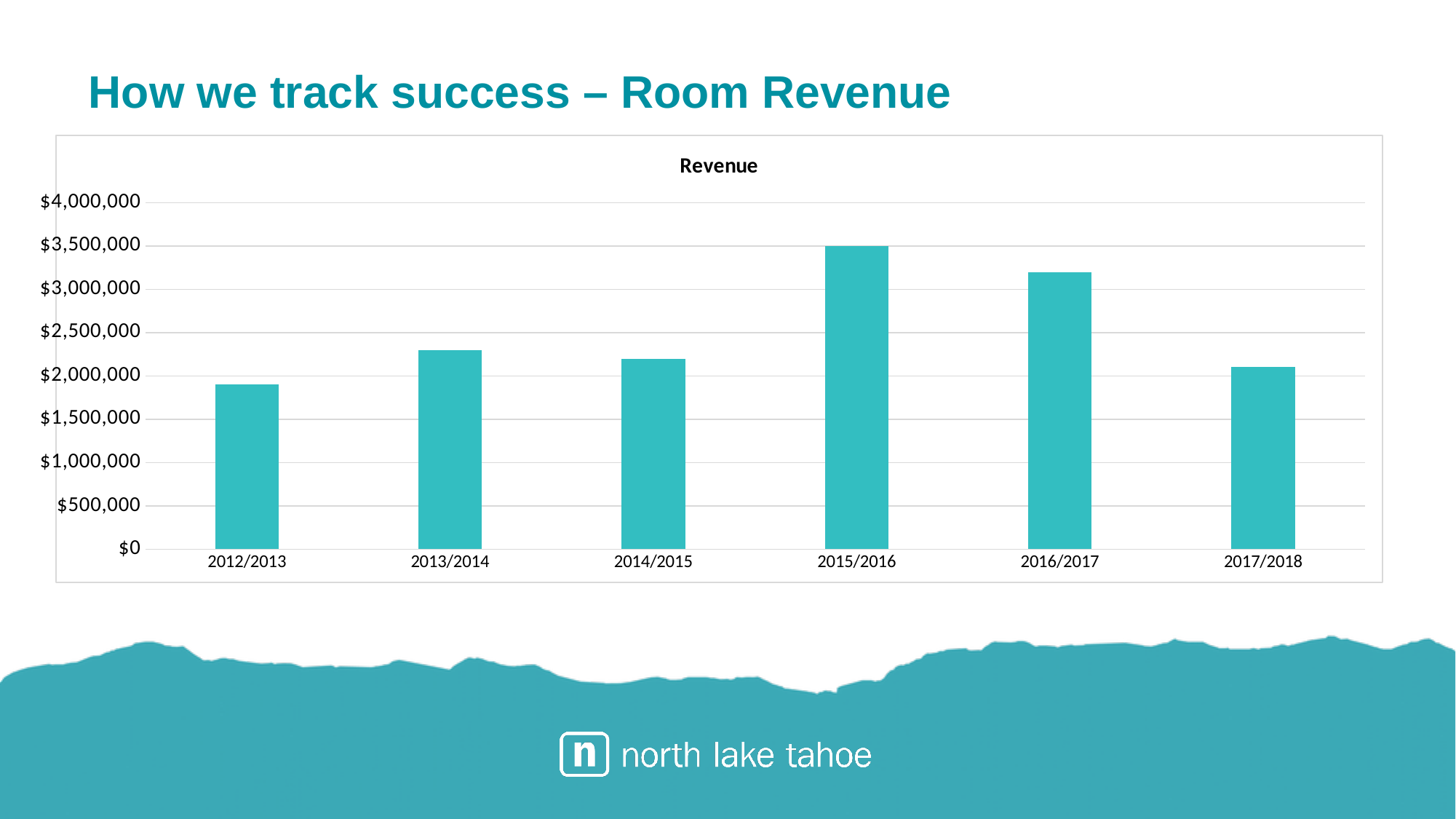
Is the revenue for 2012/2013 greater or less than $2,000,000? less How many fiscal years are shown on the x axis of the chart? 6 Is the revenue for 2014/2015 greater or less than $2,500,000? less What kind of chart is shown on the slide? bar chart Which year has the lowest revenue? 2012/2013 Is the revenue for 2016/2017 greater or less than $3,000,000? greater Which year has higher revenue, 2012/2013 or 2013/2014? 2013/2014 Which year has higher revenue, 2015/2016 or 2016/2017? 2015/2016 Which year has the highest revenue? 2015/2016 From 2015/2016 to 2017/2018, does the revenue rise or fall? fall What is the title of the chart? Revenue